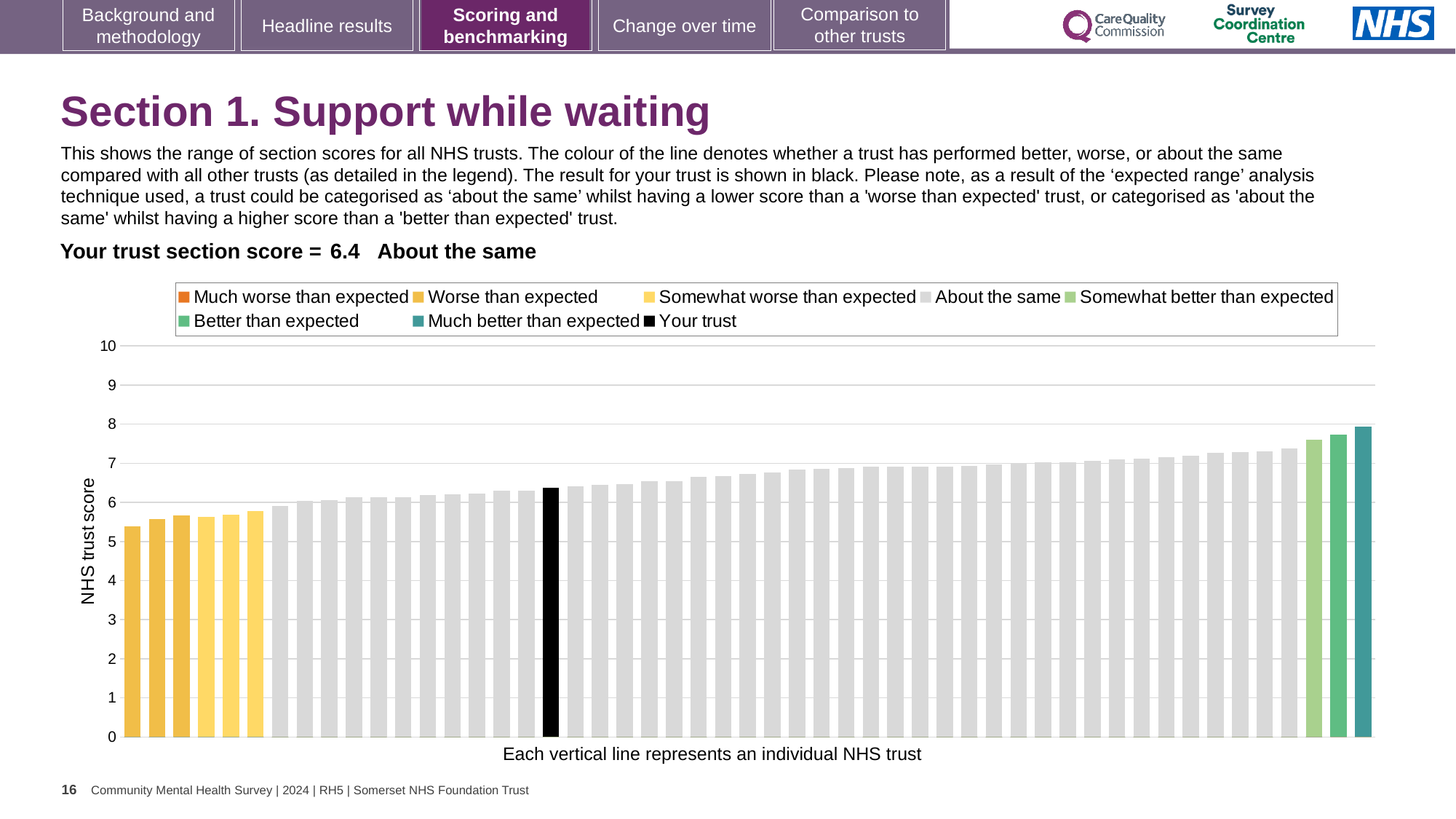
What is the label on the vertical axis of the chart? NHS trust score What is the section score for your trust shown on the slide? 6.4 Which legend category does the tallest bar belong to? Much better than expected Do the bar values rise or fall from left to right along the x axis? Rise What kind of chart is shown on the slide? Bar chart Is the value of the tallest bar in the chart greater or less than 7? greater Is the value of the black 'Your trust' bar greater or less than 6? greater How many bars are coloured as 'Worse than expected'? 3 Which is taller: the black 'Your trust' bar or the leftmost yellow bar? The black 'Your trust' bar How many entries does the chart legend list? 8 Is the value of the shortest bar in the chart greater or less than 6? less How many bars are coloured as 'Much better than expected'? 1